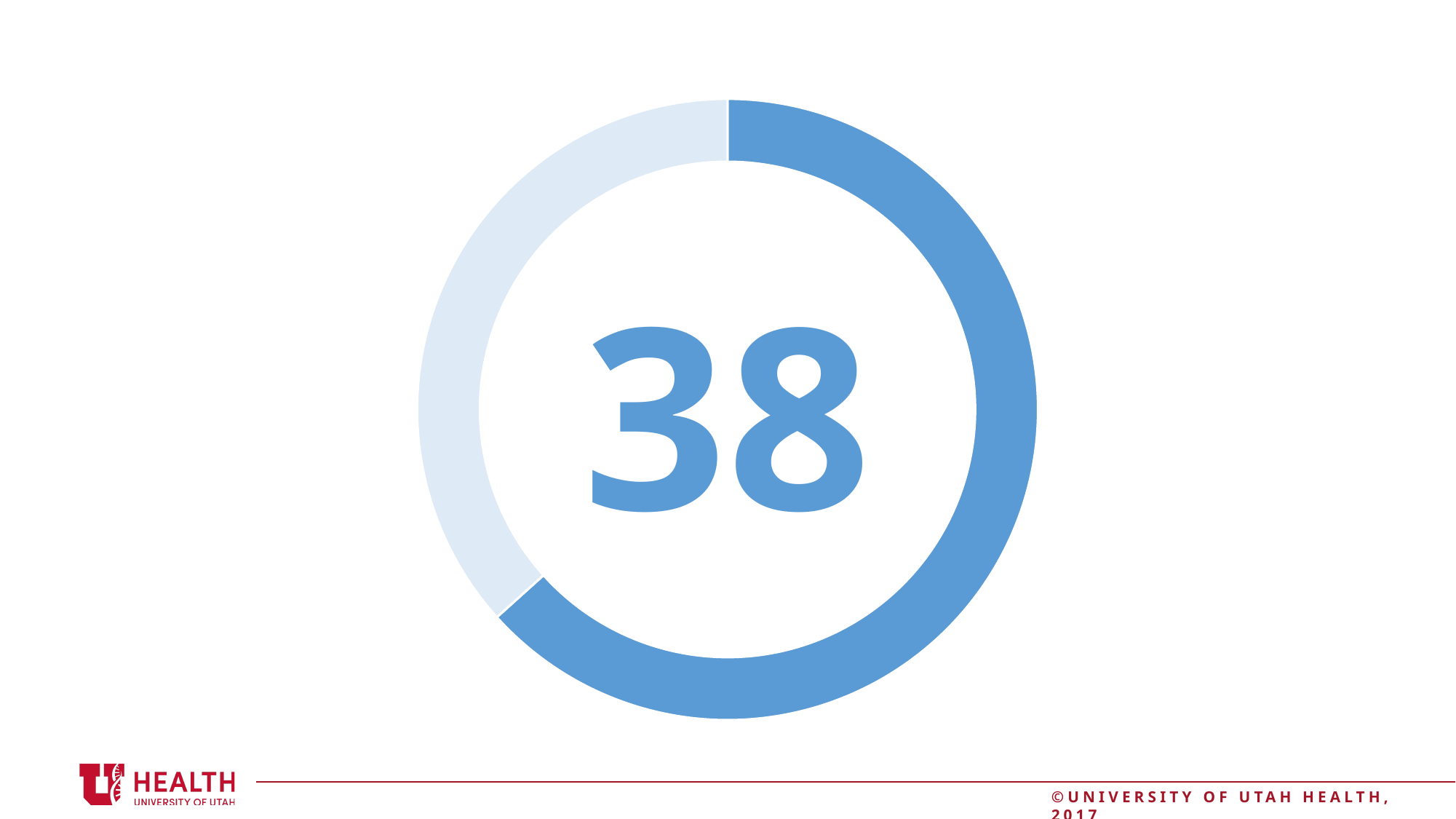
How many segments does the doughnut chart have? 2 What kind of chart is shown on the slide? doughnut chart What colour is the larger segment of the doughnut chart? dark blue Does the dark blue segment cover more or less than half of the ring? more Does the chart display a legend? No What number is displayed in the center of the doughnut chart? 38 Which segment of the doughnut chart is larger, the dark blue one or the light blue one? dark blue